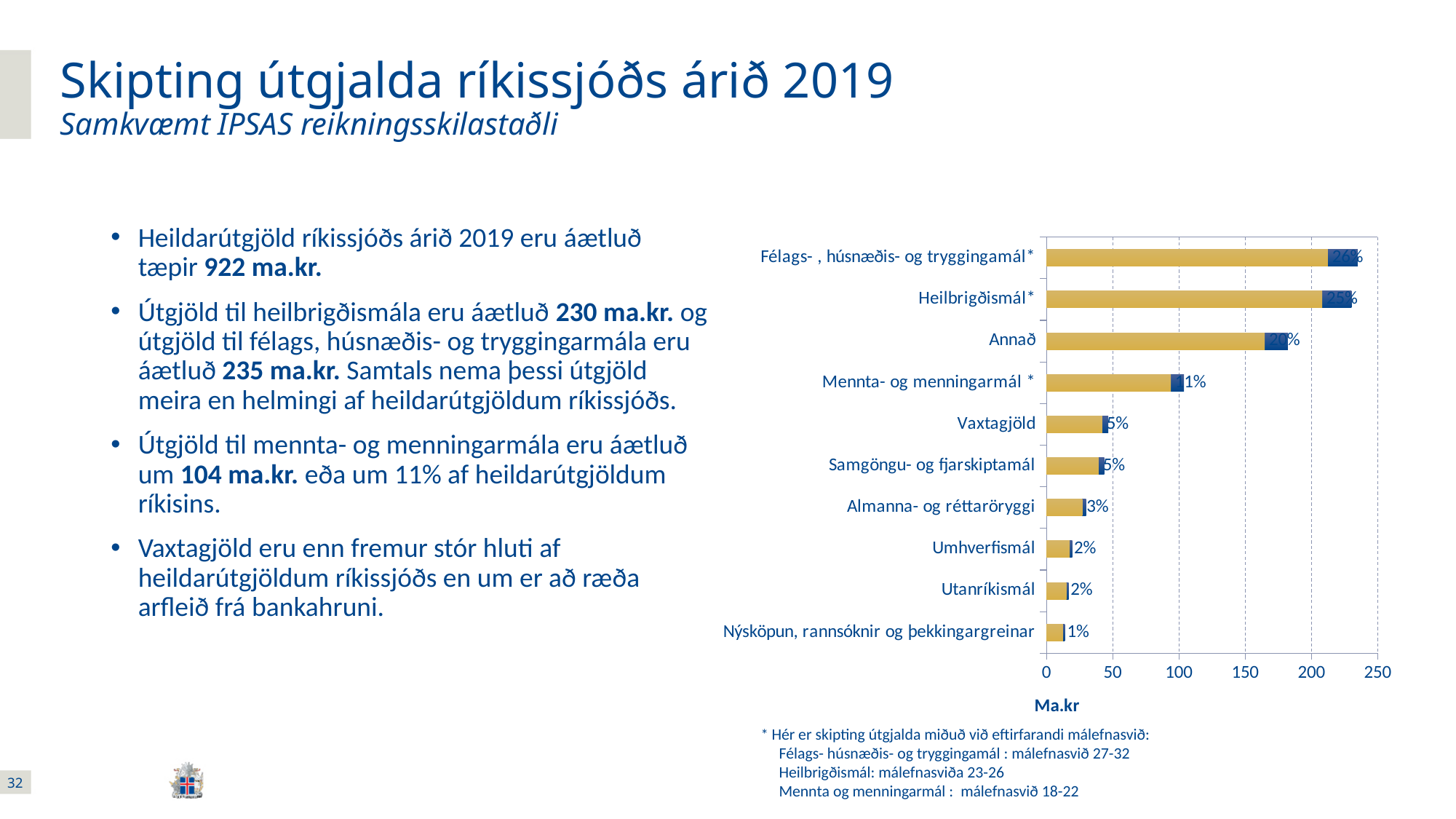
Which category has the shortest bar in the chart? Nýsköpun, rannsóknir og þekkingargreinar What percentage label is shown for Mennta- og menningarmál *? 11% Which category has the longest bar in the chart? Félags- , húsnæðis- og tryggingamál* How many categories are shown in the chart? 10 What kind of chart is shown on the slide? bar chart What percentage label is shown for Almanna- og réttaröryggi? 3% Is the value for Félags- , húsnæðis- og tryggingamál* greater or less than 200 Ma.kr? greater What percentage label is shown for Annað? 20% What is the label on the horizontal axis of the chart? Ma.kr Which has a larger value, Annað or Mennta- og menningarmál *? Annað What percentage label is shown for Heilbrigðismál*? 25%